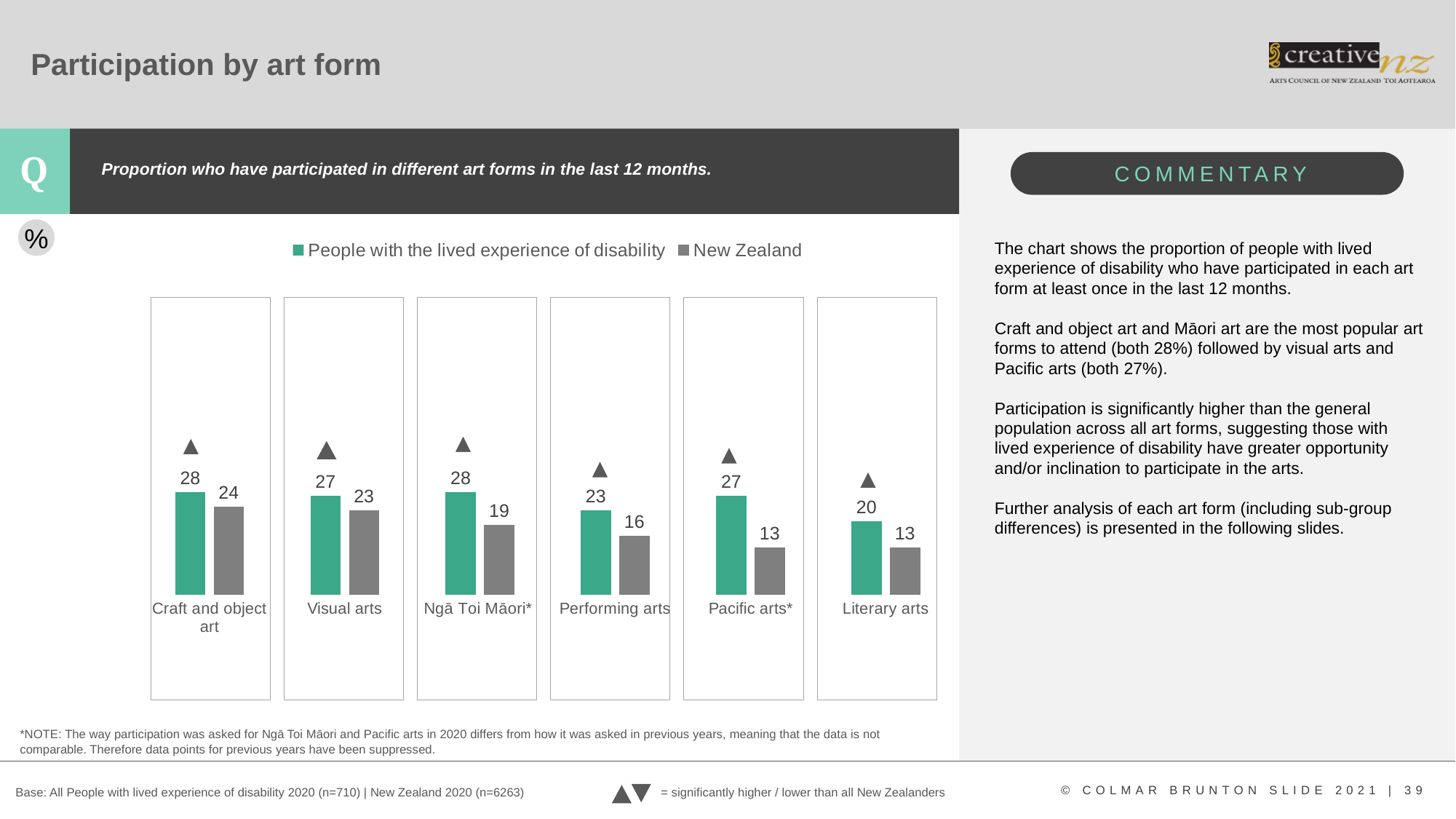
What is the value for New Zealand for Ngā Toi Māori*? 19 What is the value for People with the lived experience of disability for Literary arts? 20 How many art forms are shown on the chart? 6 Which art form has the highest value for New Zealand? Craft and object art How many series does the legend list? 2 What is the difference between the People with the lived experience of disability value and the New Zealand value for Pacific arts*? 14 What is the value for New Zealand for Craft and object art? 24 What is the value for People with the lived experience of disability for Performing arts? 23 Which is larger for Visual arts: the value for People with the lived experience of disability or the value for New Zealand? People with the lived experience of disability What kind of chart is shown on the slide? Bar chart Which art form has the lowest value for People with the lived experience of disability? Literary arts Which colour represents the New Zealand series in the chart? Grey